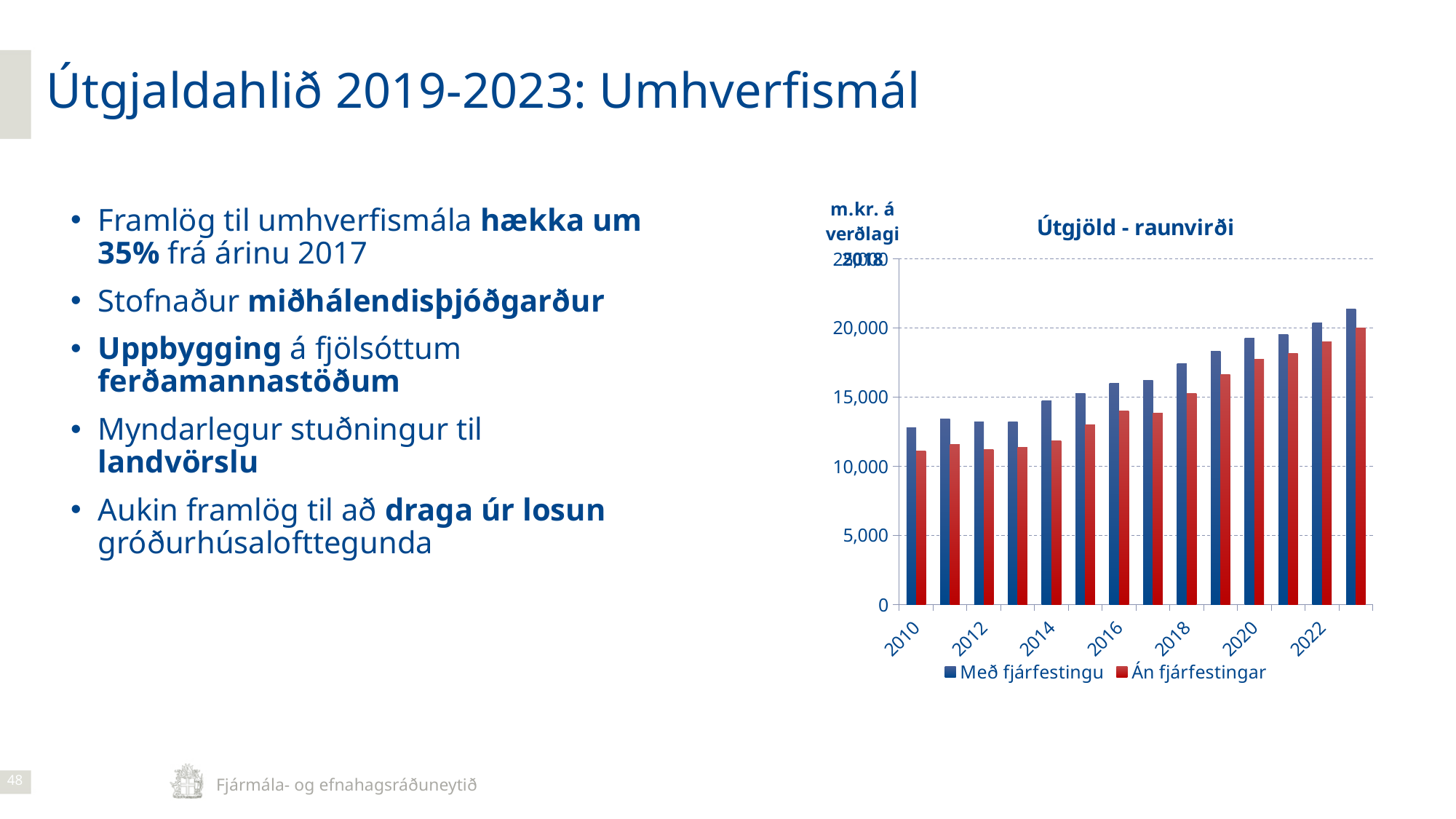
What kind of chart is shown on the slide? bar chart Do the Með fjárfestingu values generally rise or fall from 2010 to 2023? rise How many years are plotted in the chart? 14 Which is larger in 2020: Með fjárfestingu or Án fjárfestingar? Með fjárfestingu In which year is the Með fjárfestingu value highest? 2023 Is the Með fjárfestingu value for 2023 greater or less than 20,000? greater In which year is the Með fjárfestingu value lowest? 2010 Is the Með fjárfestingu value for 2020 greater or less than 20,000? less Which series is shown in red in the chart? Án fjárfestingar Is the Án fjárfestingar value for 2016 greater or less than 15,000? less How many series does the chart legend list? 2 What is the title of the chart? Útgjöld - raunvirði